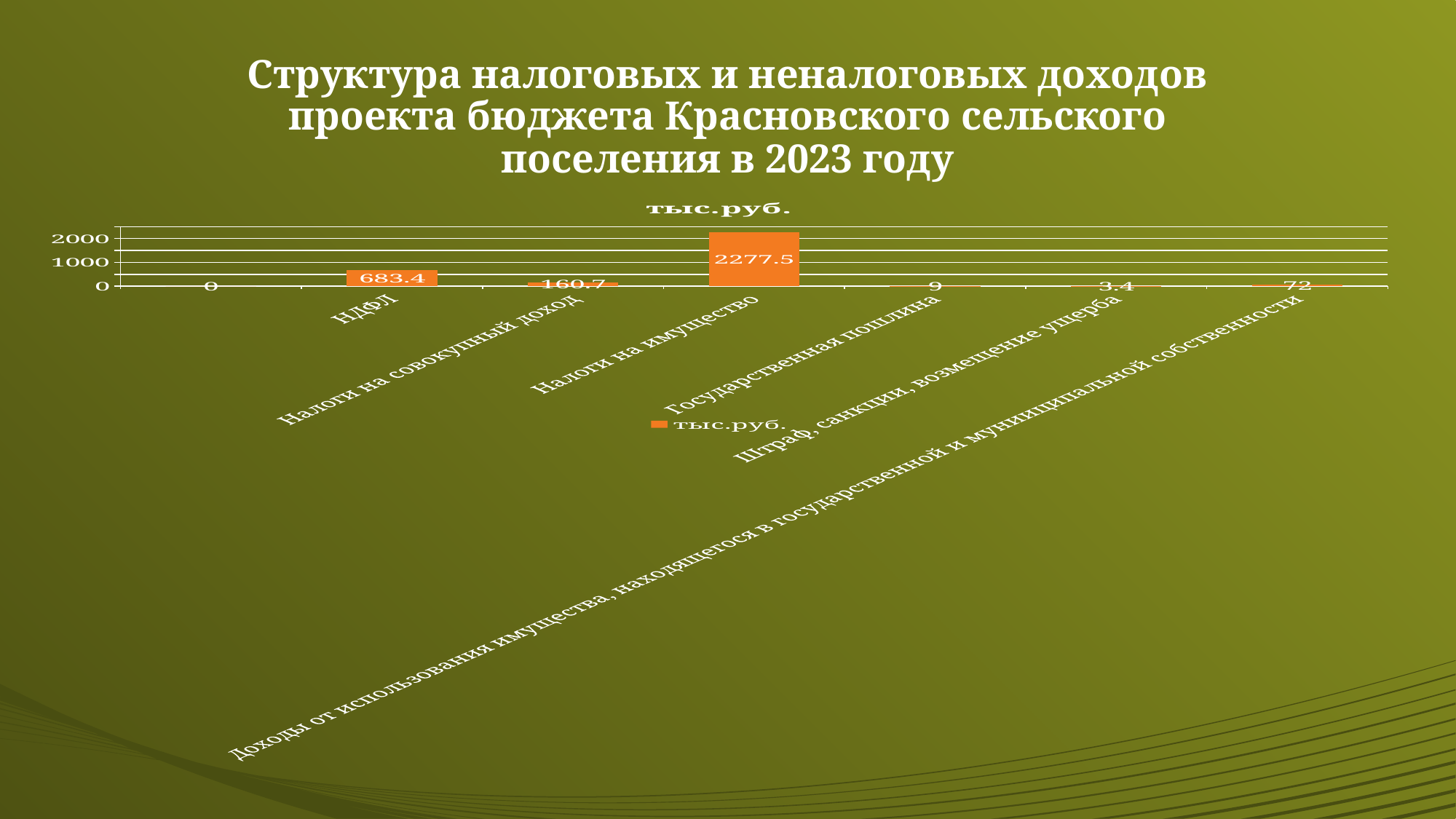
What is the value for Государственная пошлина? 9 What kind of chart is shown on the slide? bar chart What is the difference between the values for НДФЛ and Налоги на совокупный доход? 522.7 What is the value for НДФЛ? 683.4 What is the value for Налоги на имущество? 2277.5 What is the value for Налоги на совокупный доход? 160.7 What is the difference between the values for Налоги на имущество and НДФЛ? 1594.1 Which is larger, the value for Государственная пошлина or the value for Доходы от использования имущества, находящегося в государственной и муниципальной собственности? Доходы от использования имущества, находящегося в государственной и муниципальной собственности Is the value for Налоги на имущество greater or less than 2000? greater Which category has the highest value? Налоги на имущество What is the value for Штраф, санкции, возмещение ущерба? 3.4 What is the value for Доходы от использования имущества, находящегося в государственной и муниципальной собственности? 72